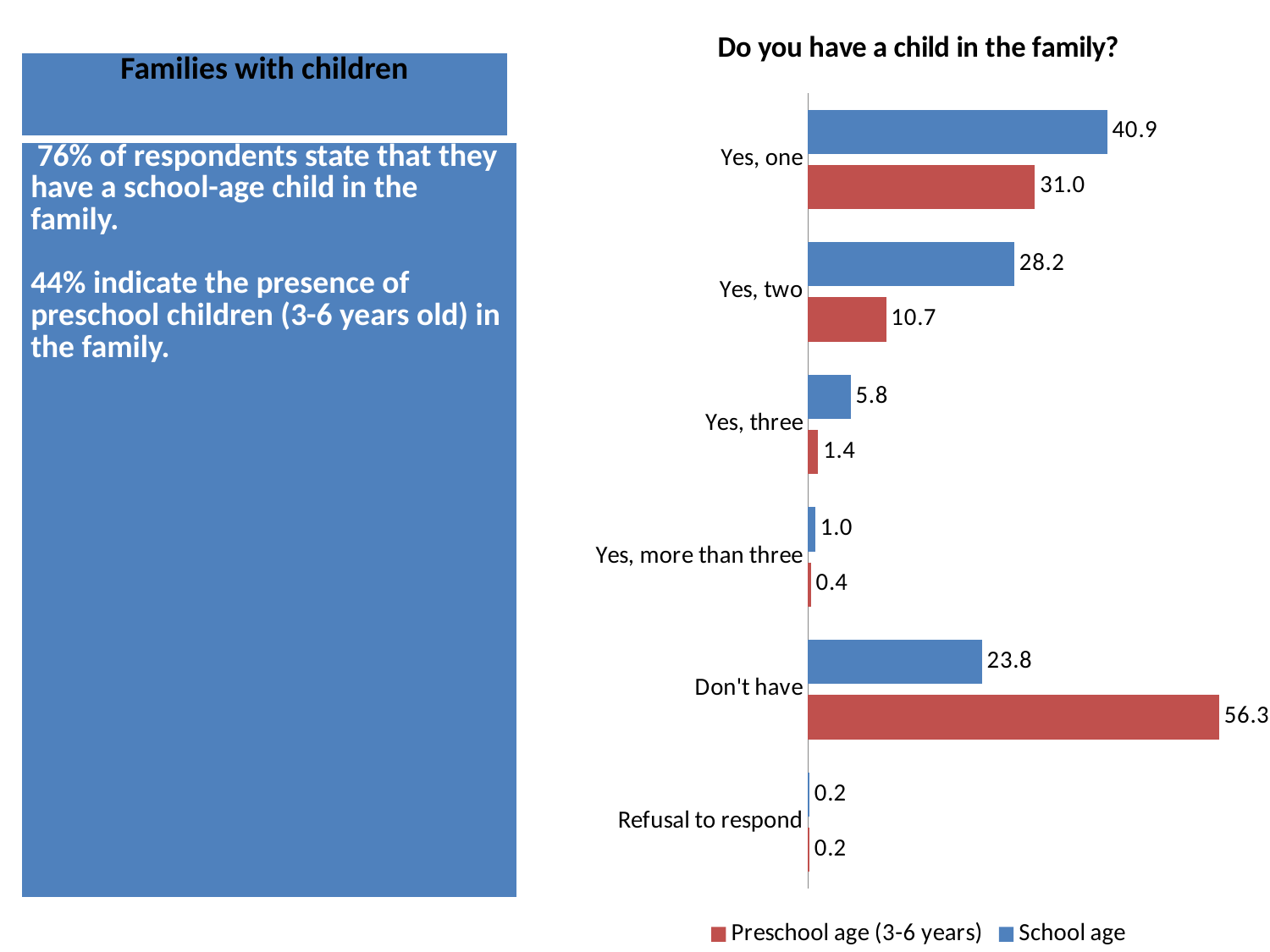
What is the difference between the School age and Preschool age (3-6 years) values for "Yes, one"? 9.9 How many categories are shown on the chart? 6 What kind of chart is shown on the slide? Bar chart What is the Preschool age (3-6 years) value for "Yes, two"? 10.7 How many series does the legend list? 2 For "Yes, three", which series has the larger value, School age or Preschool age (3-6 years)? School age What is the Preschool age (3-6 years) value for "Don't have"? 56.3 Which category has the highest School age value? Yes, one What is the School age value for "Yes, one"? 40.9 What is the title of the chart? Do you have a child in the family? What is the difference between the Preschool age (3-6 years) and School age values for "Don't have"? 32.5 Which category has the highest Preschool age (3-6 years) value? Don't have